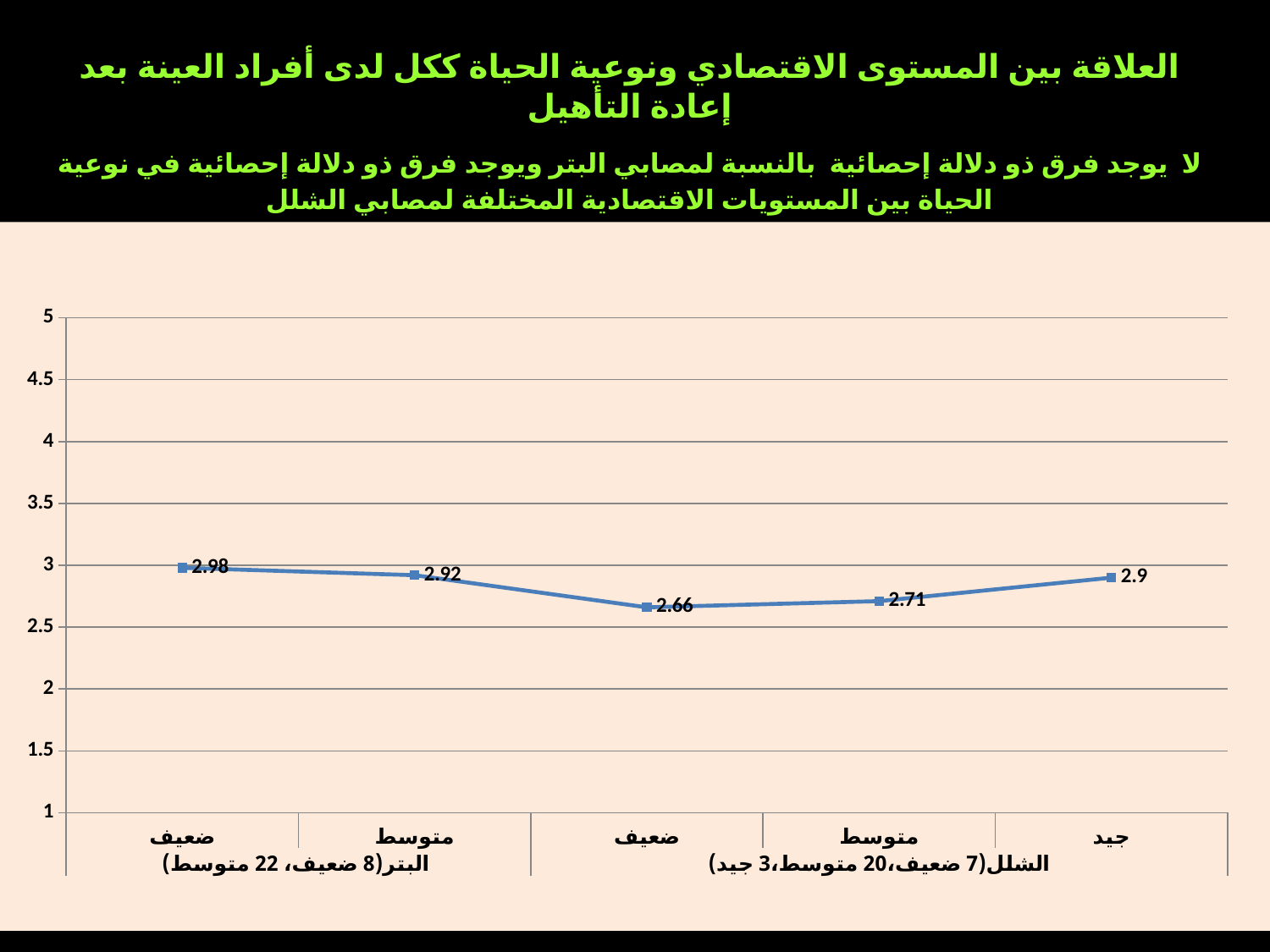
What type of chart is shown on the slide? line chart What is the value for ضعيف in the الشلل group? 2.66 Which category has the highest value? ضعيف (البتر) How many data points are plotted on the line? 5 Which category has the lowest value? ضعيف (الشلل) What is the value for ضعيف in the البتر group? 2.98 What is the value for متوسط in the البتر group? 2.92 Which is larger: the value for متوسط in the الشلل group or the value for جيد in the الشلل group? جيد (الشلل) What is the difference between the value for ضعيف in the البتر group and the value for ضعيف in the الشلل group? 0.32 Is the value for متوسط in the الشلل group greater or less than 3? less Within the الشلل group, do the values rise or fall from ضعيف to جيد? rise What is the value for جيد in the الشلل group? 2.9